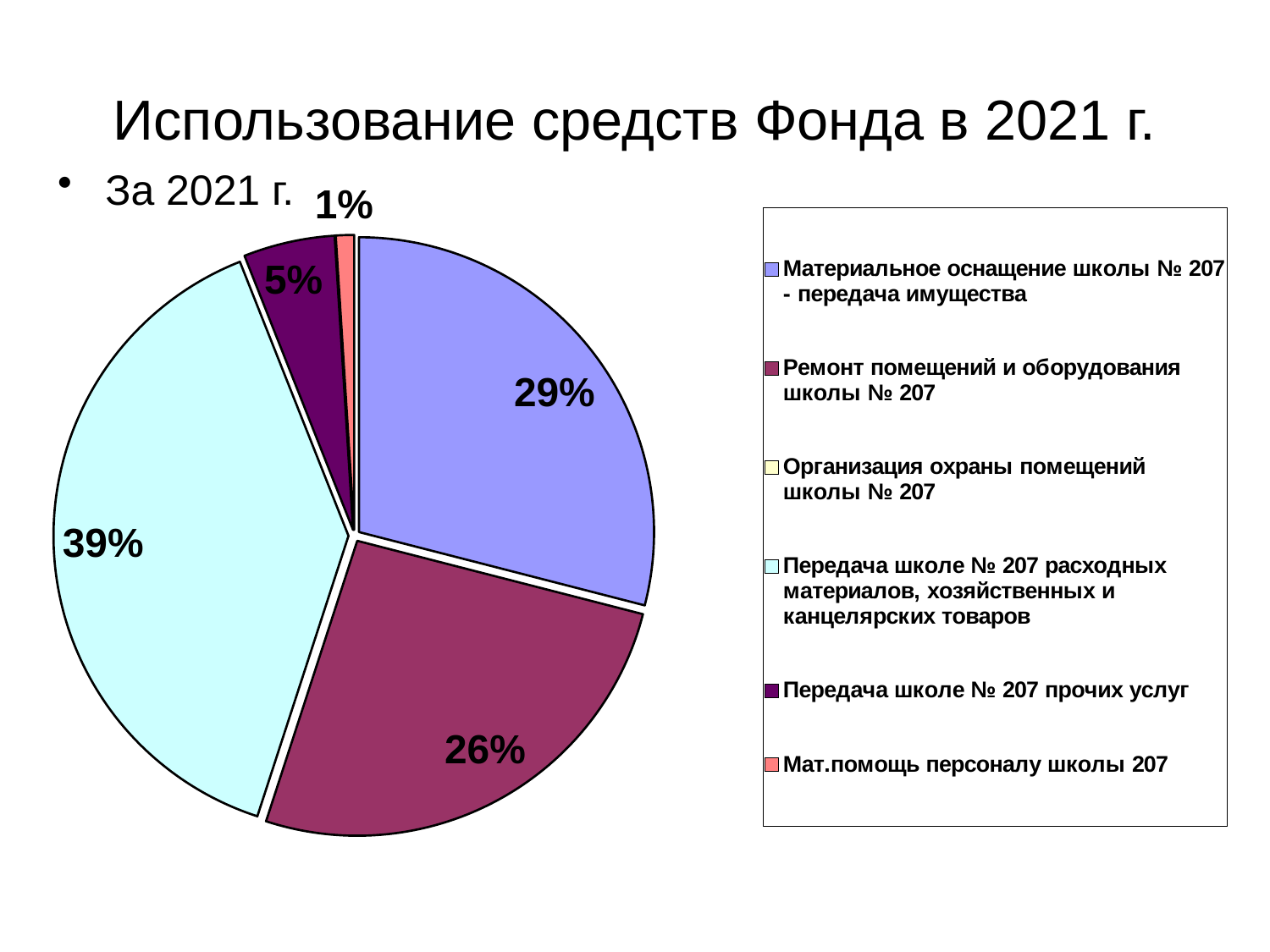
What kind of chart is shown on the slide? pie chart What is the difference in percentage points between the 39% slice and the 29% slice? 10 What is the title of the slide? Использование средств Фонда в 2021 г. What share of the pie is labelled for "Материальное оснащение школы № 207 - передача имущества"? 29% Which category has the largest slice of the pie? Передача школе № 207 расходных материалов, хозяйственных и канцелярских товаров What share of the pie is labelled for "Передача школе № 207 расходных материалов, хозяйственных и канцелярских товаров"? 39% What share of the pie is labelled for "Мат.помощь персоналу школы 207"? 1% How many entries does the legend list? 6 Which labelled slice is the smallest in the pie? Мат.помощь персоналу школы 207 What share of the pie is labelled for "Ремонт помещений и оборудования школы № 207"? 26% What share of the pie is labelled for "Передача школе № 207 прочих услуг"? 5% Which is larger: the share for "Ремонт помещений и оборудования школы № 207" or the share for "Материальное оснащение школы № 207 - передача имущества"? Материальное оснащение школы № 207 - передача имущества